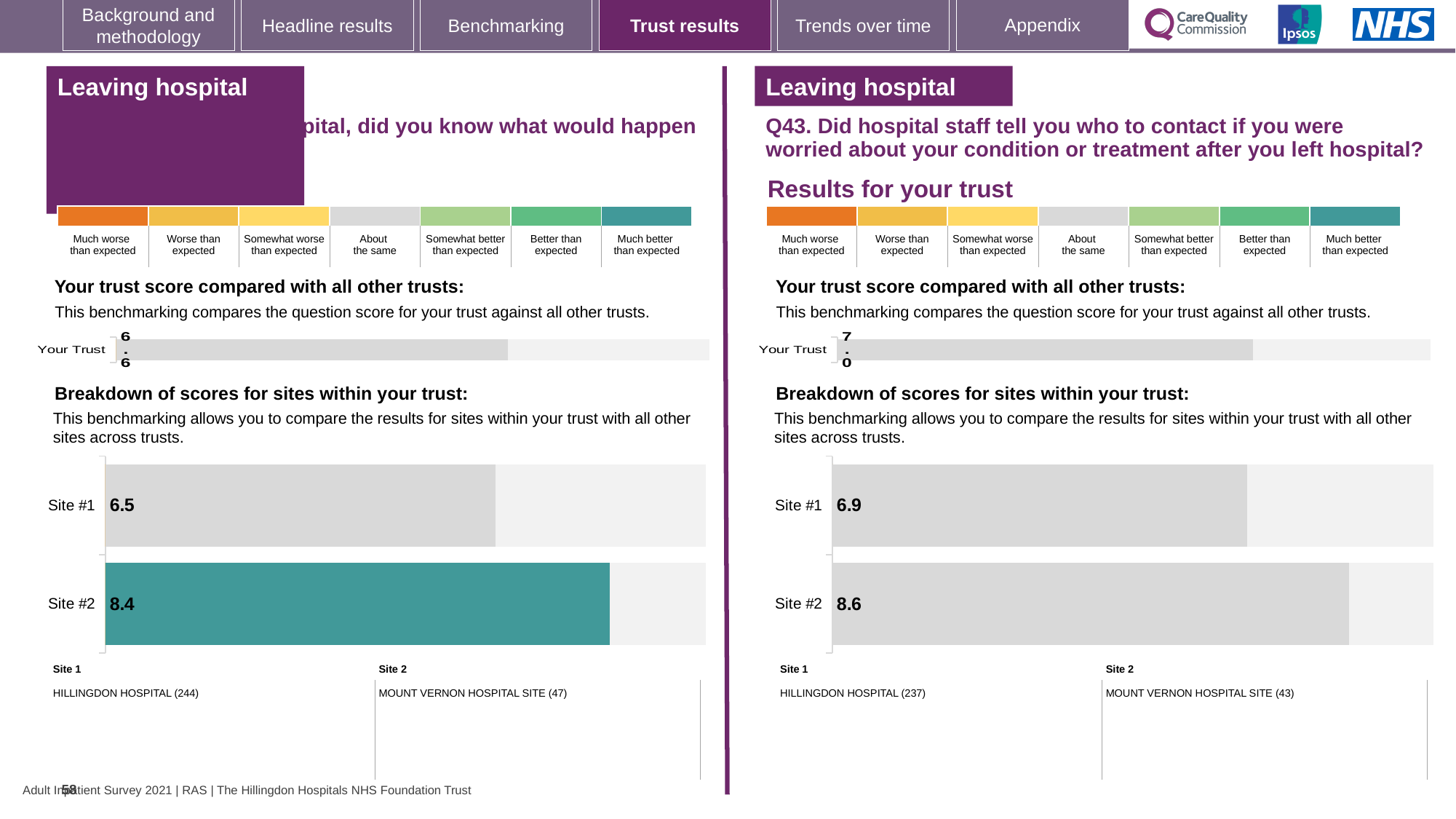
On the left-hand site breakdown chart, what is the score for Site #2? 8.4 On the left-hand 'Your trust score compared with all other trusts' chart, what is the score for Your Trust? 6.6 On the left-hand site breakdown chart, what is the score for Site #1? 6.5 On the left-hand site breakdown chart, what is the difference between the Site #2 and Site #1 scores? 1.9 How many sites are shown on the right-hand (Q43) site breakdown chart? 2 On the right-hand (Q43) site breakdown chart, what is the difference between the Site #2 and Site #1 scores? 1.7 On the left-hand site breakdown chart, which site has the lower score? Site #1 What type of chart is the left-hand site breakdown chart? Bar chart On the right-hand (Q43) site breakdown chart, what is the score for Site #1? 6.9 On the right-hand (Q43) 'Your trust score compared with all other trusts' chart, what is the score for Your Trust? 7.0 On the right-hand (Q43) site breakdown chart, what is the score for Site #2? 8.6 On the right-hand (Q43) site breakdown chart, which site has the higher score? Site #2